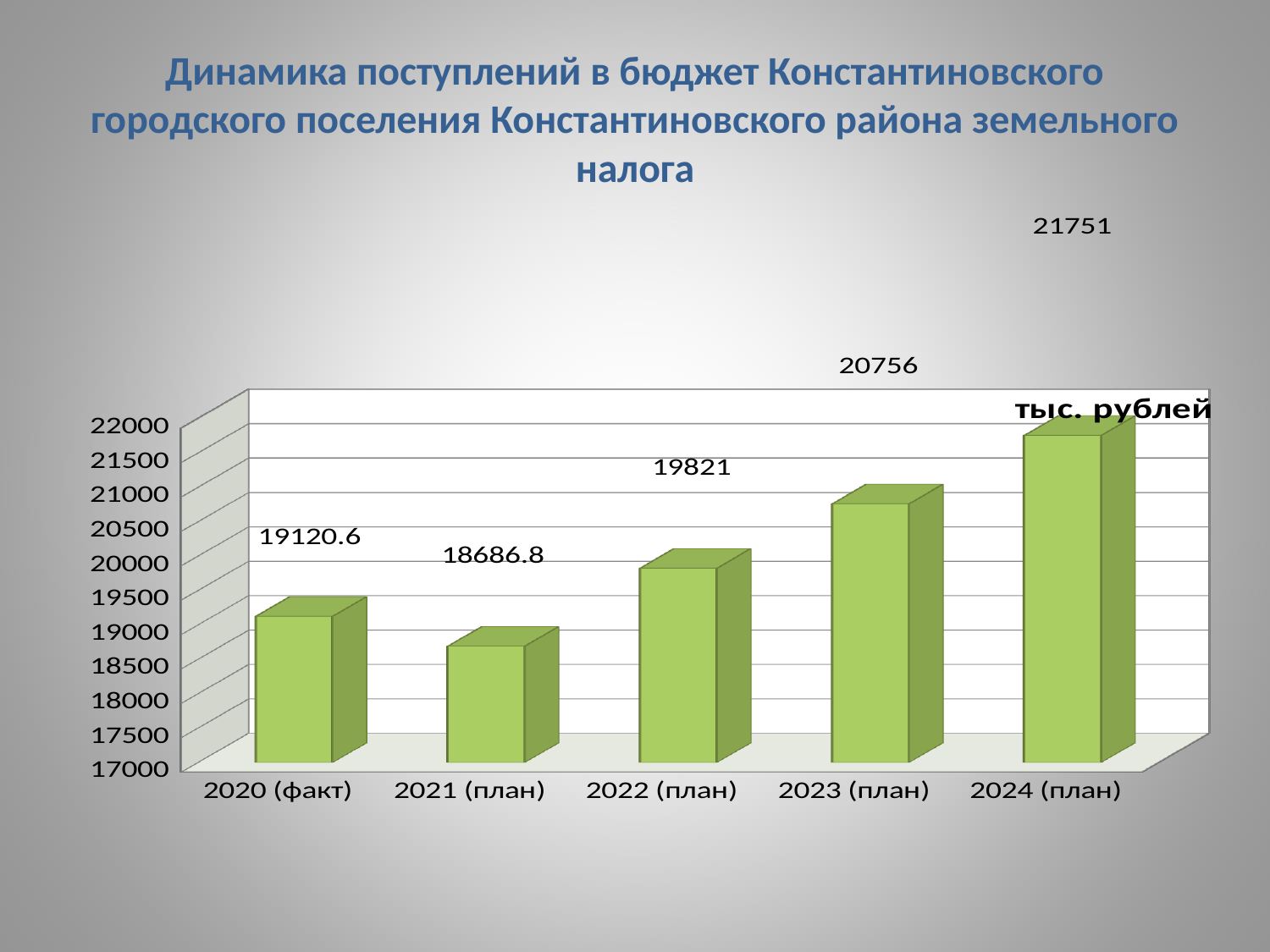
What is the value for 2020 (факт)? 19120.6 Which year has the lowest value? 2021 (план) What is the difference between the values for 2024 (план) and 2023 (план)? 995 How many categories are shown on the x axis? 5 What is the difference between the values for 2020 (факт) and 2021 (план)? 433.8 What unit of measurement is indicated on the chart? тыс. рублей What is the value for 2023 (план)? 20756 Which is larger, the value for 2022 (план) or the value for 2020 (факт)? 2022 (план) What is the value for 2024 (план)? 21751 What is the value for 2021 (план)? 18686.8 What kind of chart is shown on the slide? bar chart Which year has the highest value? 2024 (план)